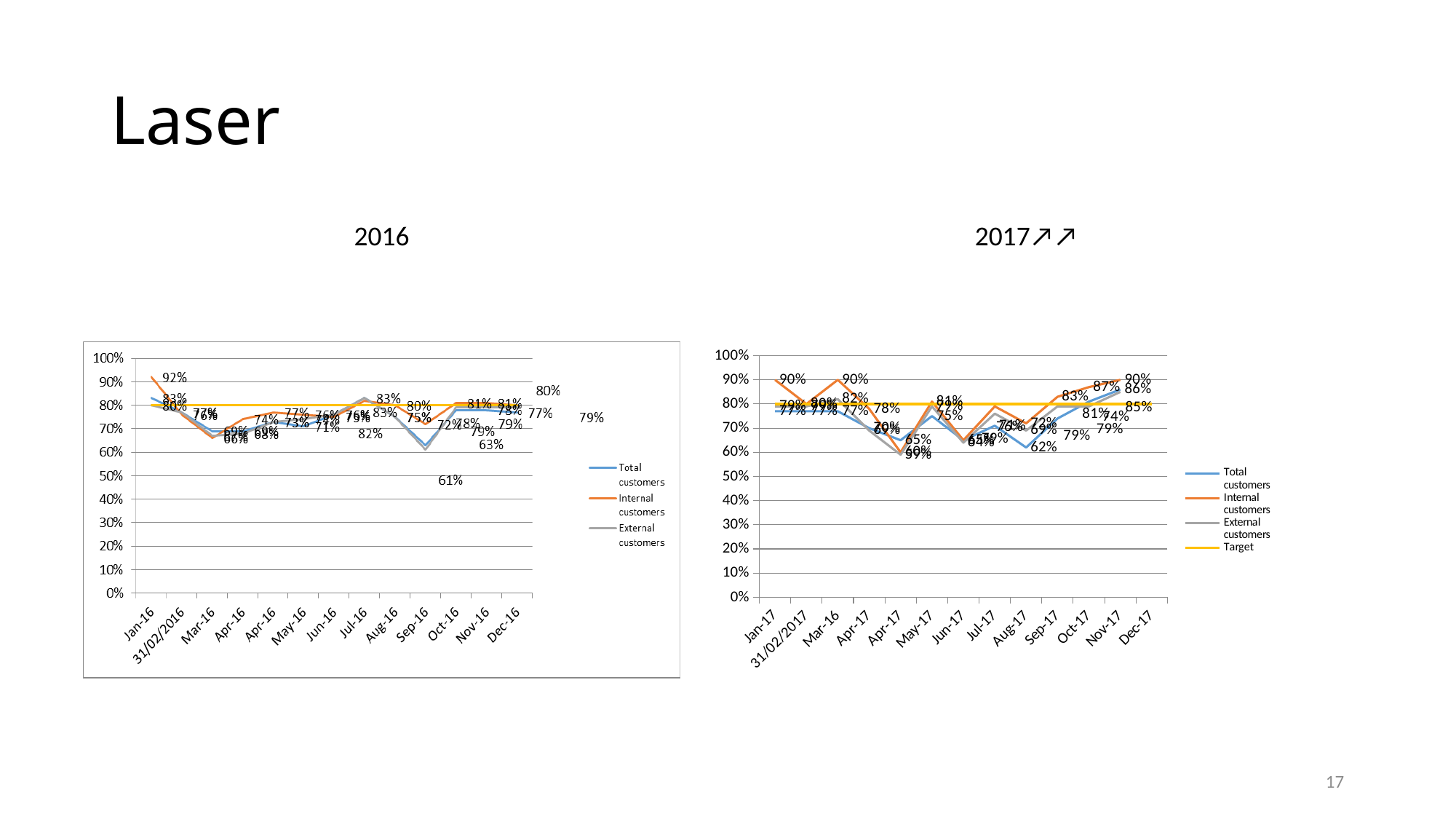
In the 2016 chart, at which month does Internal customers reach its highest value? Jan-16 In the 2017 chart, what is the value for Total customers at Aug-17? 62% In the 2016 chart, is the value for Total customers at Sep-16 greater or less than 70%? less In the 2017 chart, which is larger at Jan-17: Internal customers or Total customers? Internal customers In the 2017 chart, what is the difference between Internal customers (90%) and Total customers (77%) at Jan-17? 13 percentage points What kind of chart is the 2016 chart? line chart How many series does the legend of the 2017 chart list? 4 In the 2017 chart, at what level is the Target line drawn? 80% How many series does the legend of the 2016 chart list? 3 In the 2017 chart, what is the value for Internal customers at Jan-17? 90% How many categories are on the x axis of the 2017 chart? 13 In the 2016 chart, what is the value for Internal customers at Jan-16? 92%